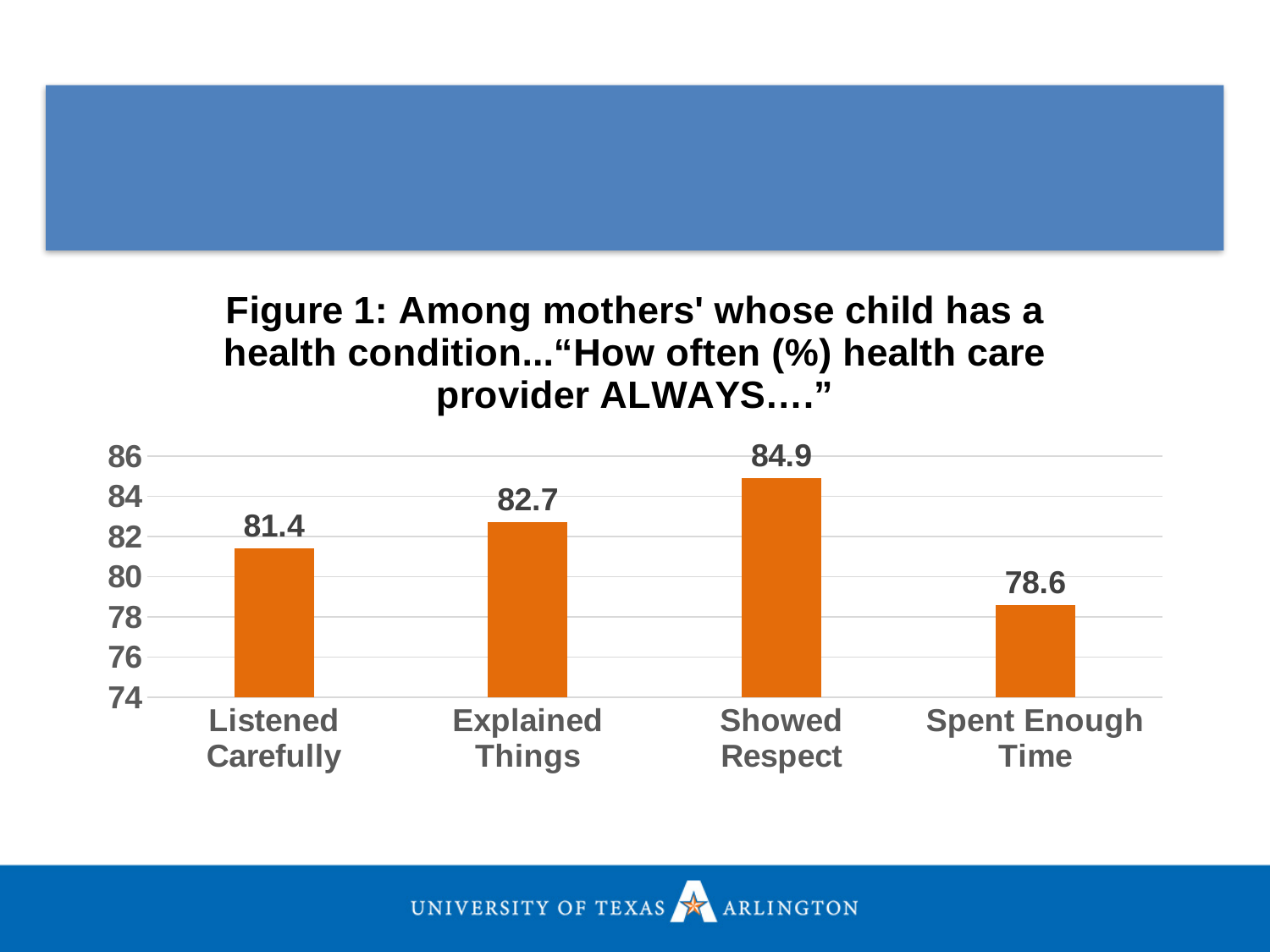
What is the value for Explained Things? 82.7 What is the value for Spent Enough Time? 78.6 What is the difference between the values for Showed Respect and Spent Enough Time? 6.3 Which category has the highest value? Showed Respect Which category has the lowest value? Spent Enough Time What is the value for Listened Carefully? 81.4 What is the value for Showed Respect? 84.9 Which is larger, the value for Listened Carefully or the value for Spent Enough Time? Listened Carefully Is the value for Spent Enough Time greater or less than 80? less What kind of chart is shown on the slide? bar chart How many categories are shown in the chart? 4 What is the difference between the values for Explained Things and Listened Carefully? 1.3